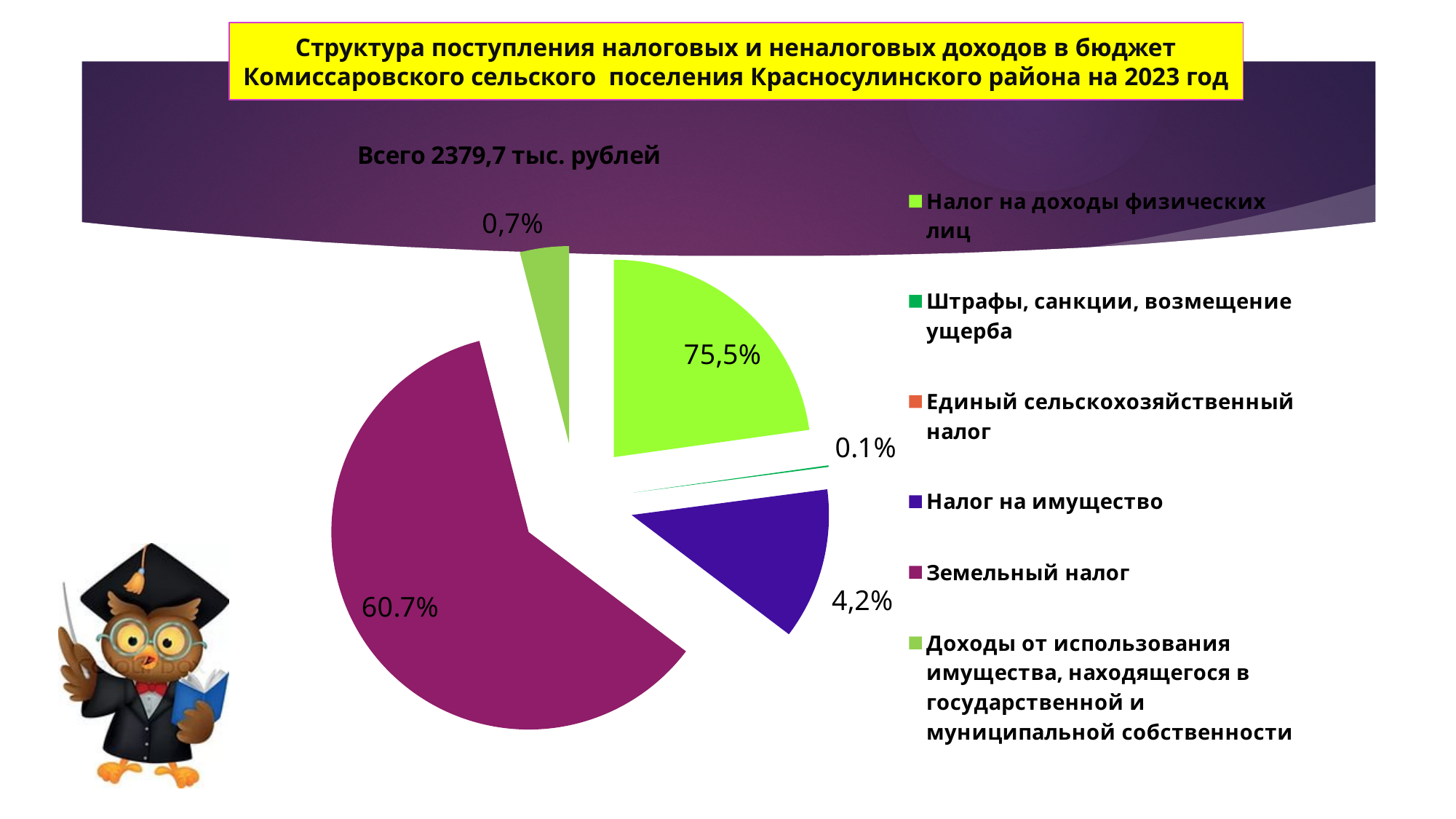
What share is shown for Налог на доходы физических лиц? 75,5% How many entries does the legend of the pie chart list? 6 What colour is the slice for Земельный налог? magenta (purple-red) What share is shown for Штрафы, санкции, возмещение ущерба? 0.1% What kind of chart is shown on the slide? pie chart What total amount is stated above the pie chart? Всего 2379,7 тыс. рублей What share is shown for Земельный налог? 60.7% What share is shown for Доходы от использования имущества, находящегося в государственной и муниципальной собственности? 0,7% Which category has the smallest share in the pie chart? Штрафы, санкции, возмещение ущерба What is the difference between the share for Налог на имущество and the share for Доходы от использования имущества, находящегося в государственной и муниципальной собственности? 3,5% Which is larger: the share for Налог на имущество or the share for Доходы от использования имущества, находящегося в государственной и муниципальной собственности? Налог на имущество What share is shown for Налог на имущество? 4,2%